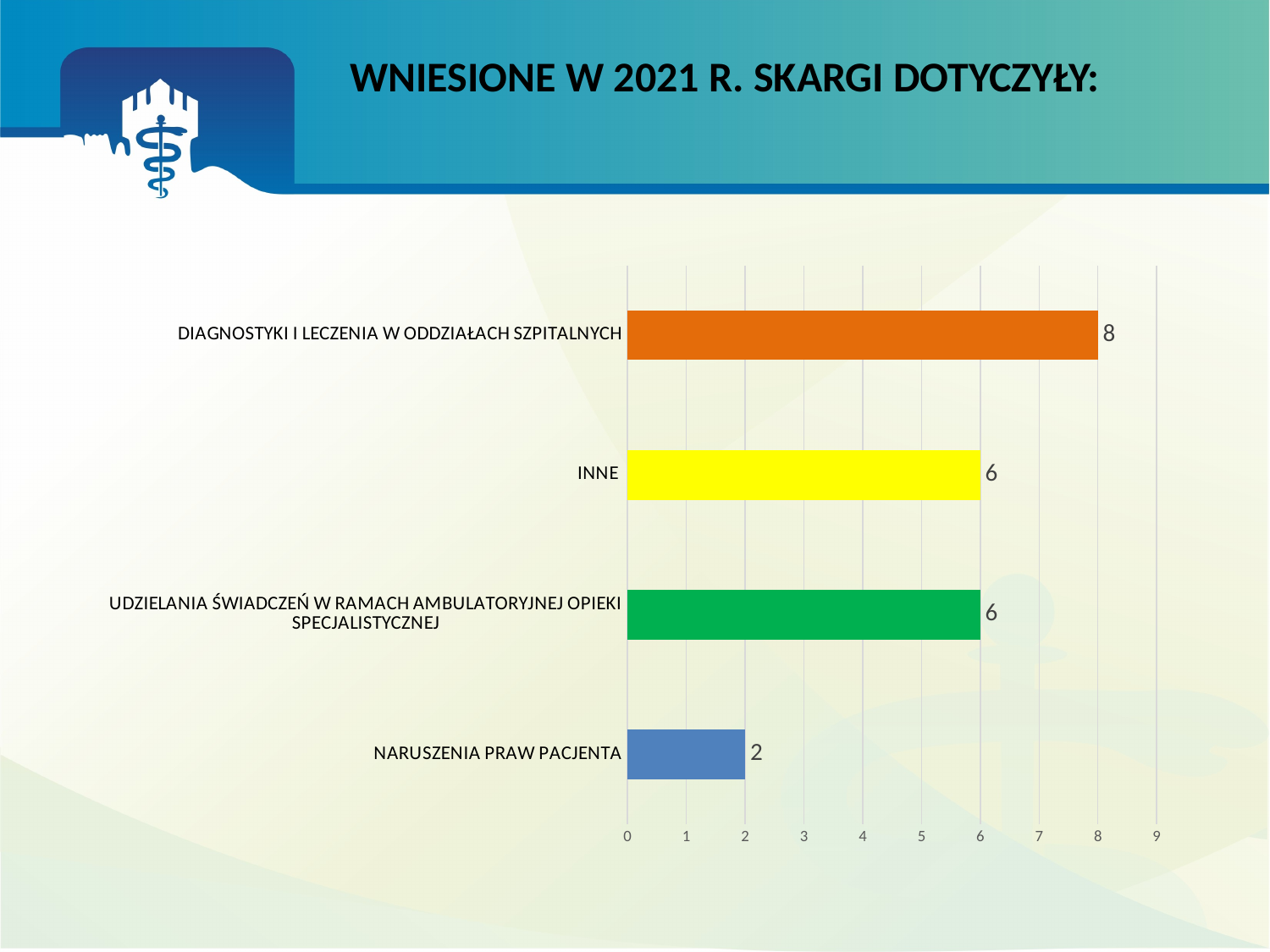
What is the value for UDZIELANIA ŚWIADCZEŃ W RAMACH AMBULATORYJNEJ OPIEKI SPECJALISTYCZNEJ? 6 How many categories are shown in the chart? 4 Which category has the highest value? DIAGNOSTYKI I LECZENIA W ODDZIAŁACH SZPITALNYCH What is the value for DIAGNOSTYKI I LECZENIA W ODDZIAŁACH SZPITALNYCH? 8 What is the value for INNE? 6 What is the title of the slide? WNIESIONE W 2021 R. SKARGI DOTYCZYŁY: Which category has the lowest value? NARUSZENIA PRAW PACJENTA What is the difference between the values for DIAGNOSTYKI I LECZENIA W ODDZIAŁACH SZPITALNYCH and NARUSZENIA PRAW PACJENTA? 6 What is the difference between the values for INNE and NARUSZENIA PRAW PACJENTA? 4 What kind of chart is shown on the slide? bar chart What is the value for NARUSZENIA PRAW PACJENTA? 2 Which is larger, the value for INNE or the value for NARUSZENIA PRAW PACJENTA? INNE